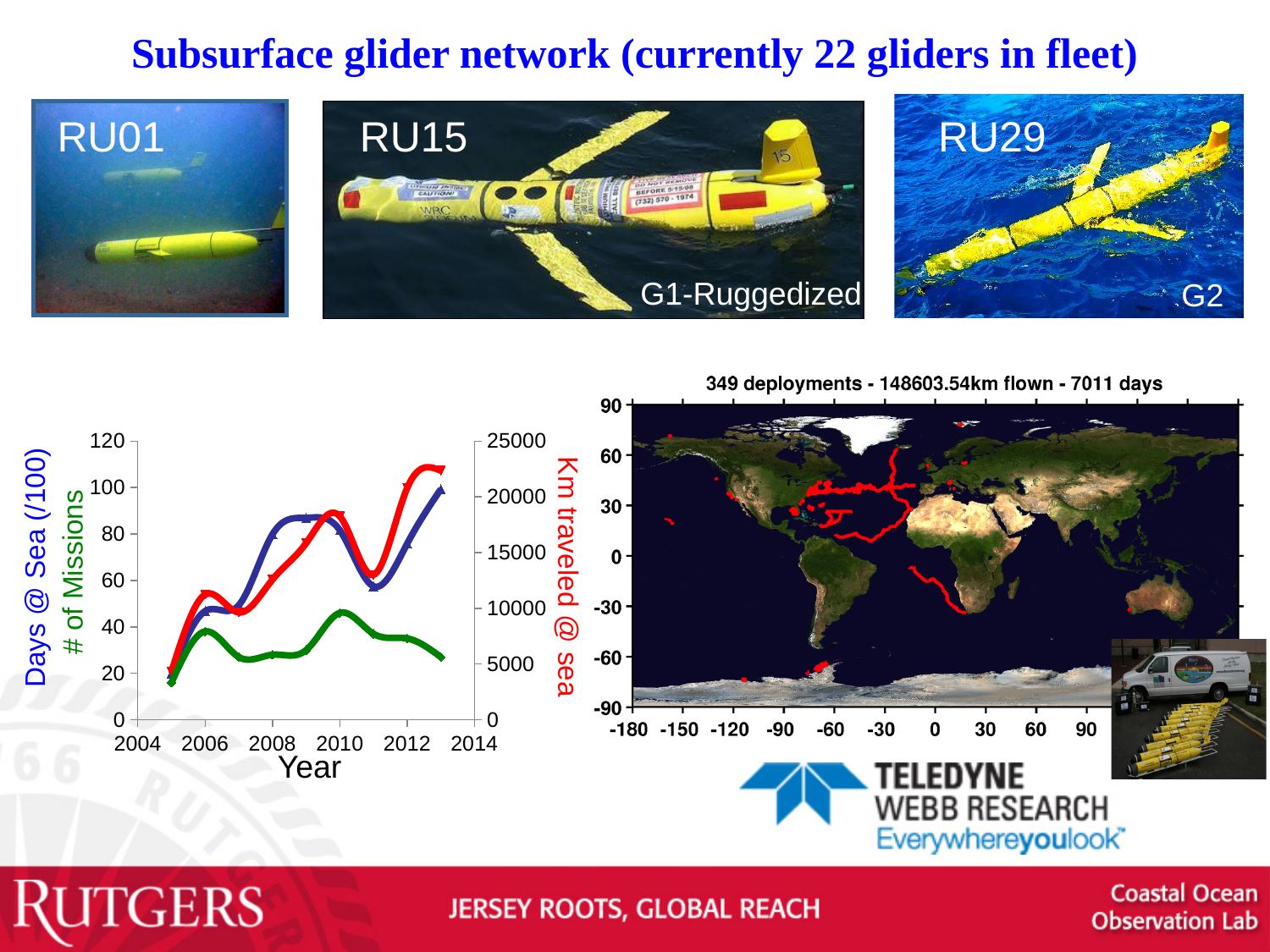
In the line chart, is the red Km traveled @ sea value for 2011 greater or less than 15000 on the right axis? less In the line chart, what is the title of the x axis? Year In the line chart, is the red Km traveled @ sea value for 2013 greater or less than 20000 on the right axis? greater In the line chart, what is the label of the right-hand y axis? Km traveled @ sea In the line chart, in which year does the green # of Missions line reach its highest value? 2010 What kind of chart is shown at the bottom left of the slide? line chart In the line chart, does the green # of Missions line rise or fall from 2010 to 2013? fall In the line chart, how many data points does each line have (one per year)? 9 In the line chart, in which year does the red Km traveled @ sea line reach its highest value? 2013 In the line chart, in which year is the green # of Missions line at its lowest? 2005 In the line chart, is the green # of Missions value for 2010 greater or less than 40? greater In the line chart, which is higher in 2012: the blue Days @ Sea line or the green # of Missions line? blue Days @ Sea